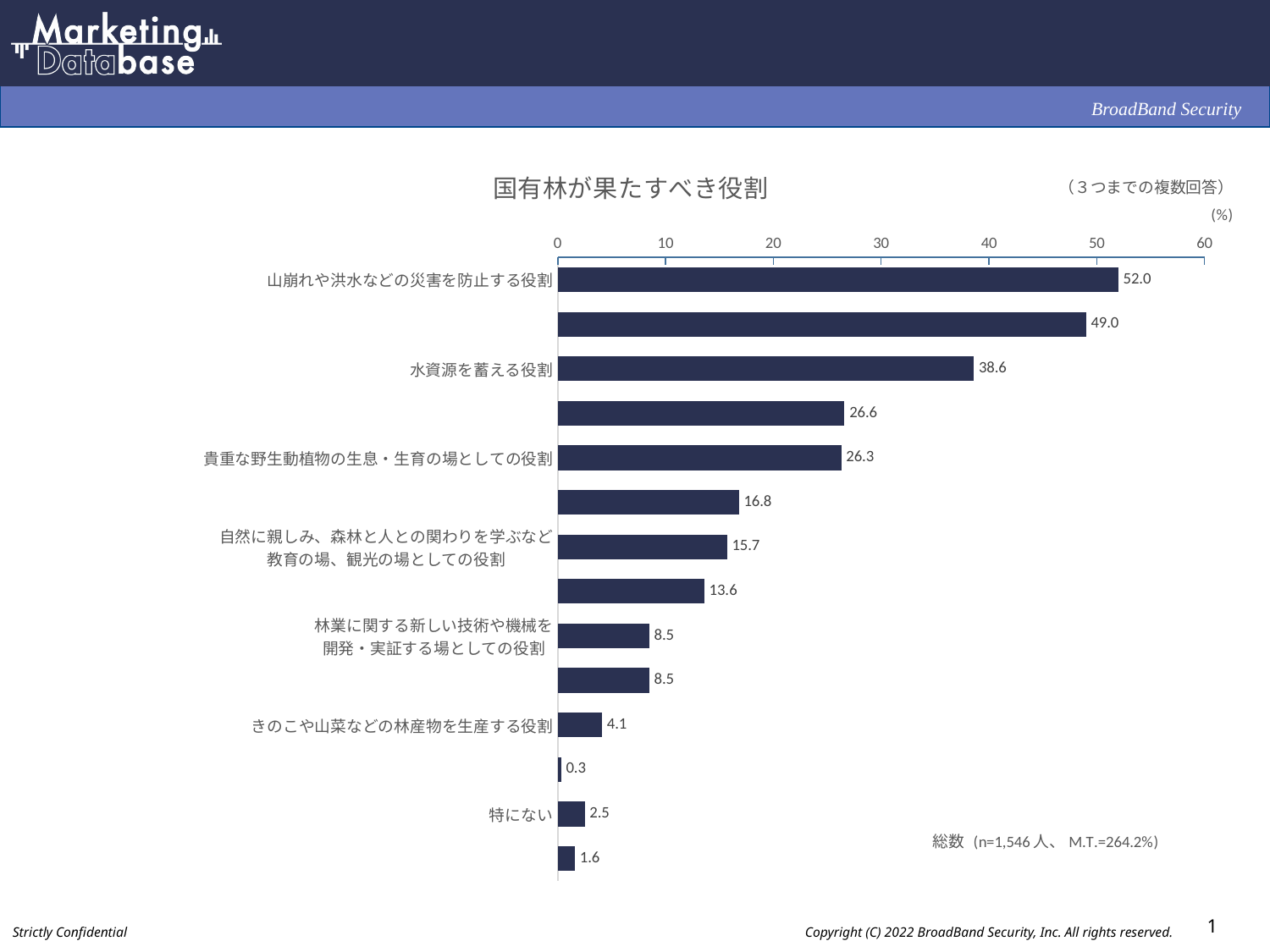
Is the value for 山崩れや洪水などの災害を防止する役割 greater or less than 50? greater What kind of chart is shown on the slide? bar chart What is the difference between the values for 山崩れや洪水などの災害を防止する役割 and 水資源を蓄える役割? 13.4 What is the value for 水資源を蓄える役割? 38.6 What is the value for 貴重な野生動植物の生息・生育の場としての役割? 26.3 What is the value for きのこや山菜などの林産物を生産する役割? 4.1 Which is larger, the value for 水資源を蓄える役割 or the value for 貴重な野生動植物の生息・生育の場としての役割? 水資源を蓄える役割 What is the value for 山崩れや洪水などの災害を防止する役割? 52.0 What is the value for 自然に親しみ、森林と人との関わりを学ぶなど教育の場、観光の場としての役割? 15.7 What is the value for 特にない? 2.5 Which category has the highest value? 山崩れや洪水などの災害を防止する役割 How many bars are plotted in the chart? 14